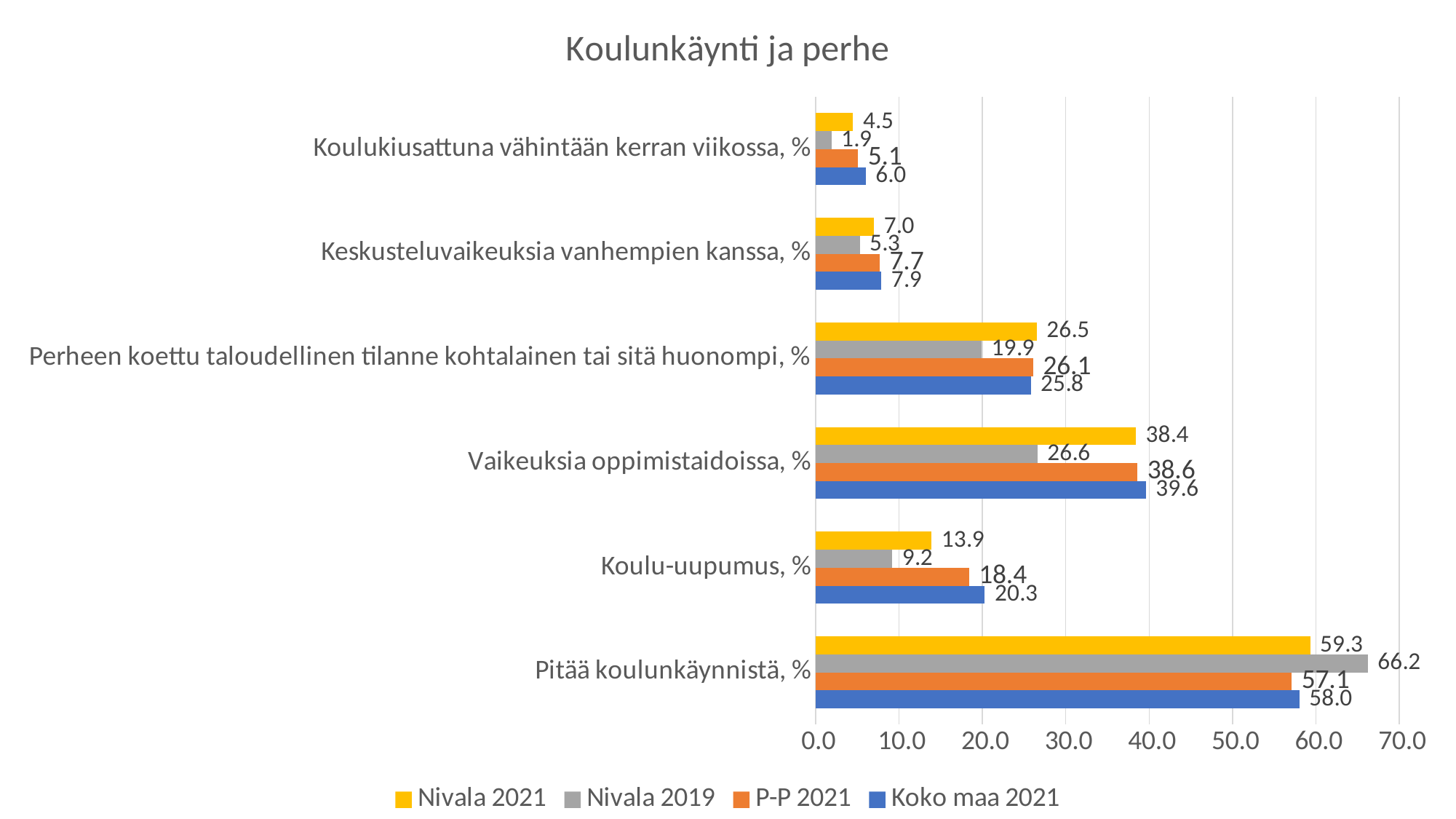
What is the value for Nivala 2019 in the category "Pitää koulunkäynnistä, %"? 66.2 How many series does the legend list? 4 In the category "Perheen koettu taloudellinen tilanne kohtalainen tai sitä huonompi, %", which is larger: Nivala 2021 or Nivala 2019? Nivala 2021 Which category has the lowest value for Nivala 2019? Koulukiusattuna vähintään kerran viikossa, % What is the title of the chart? Koulunkäynti ja perhe What is the value for Koko maa 2021 in the category "Vaikeuksia oppimistaidoissa, %"? 39.6 What is the difference between the Nivala 2021 and Nivala 2019 values for "Koulu-uupumus, %"? 4.7 What kind of chart is shown on the slide? Bar chart What is the value for Nivala 2021 in the category "Koulu-uupumus, %"? 13.9 What is the value for P-P 2021 in the category "Koulukiusattuna vähintään kerran viikossa, %"? 5.1 Which category has the highest value for Nivala 2021? Pitää koulunkäynnistä, % How many categories are shown on the chart? 6